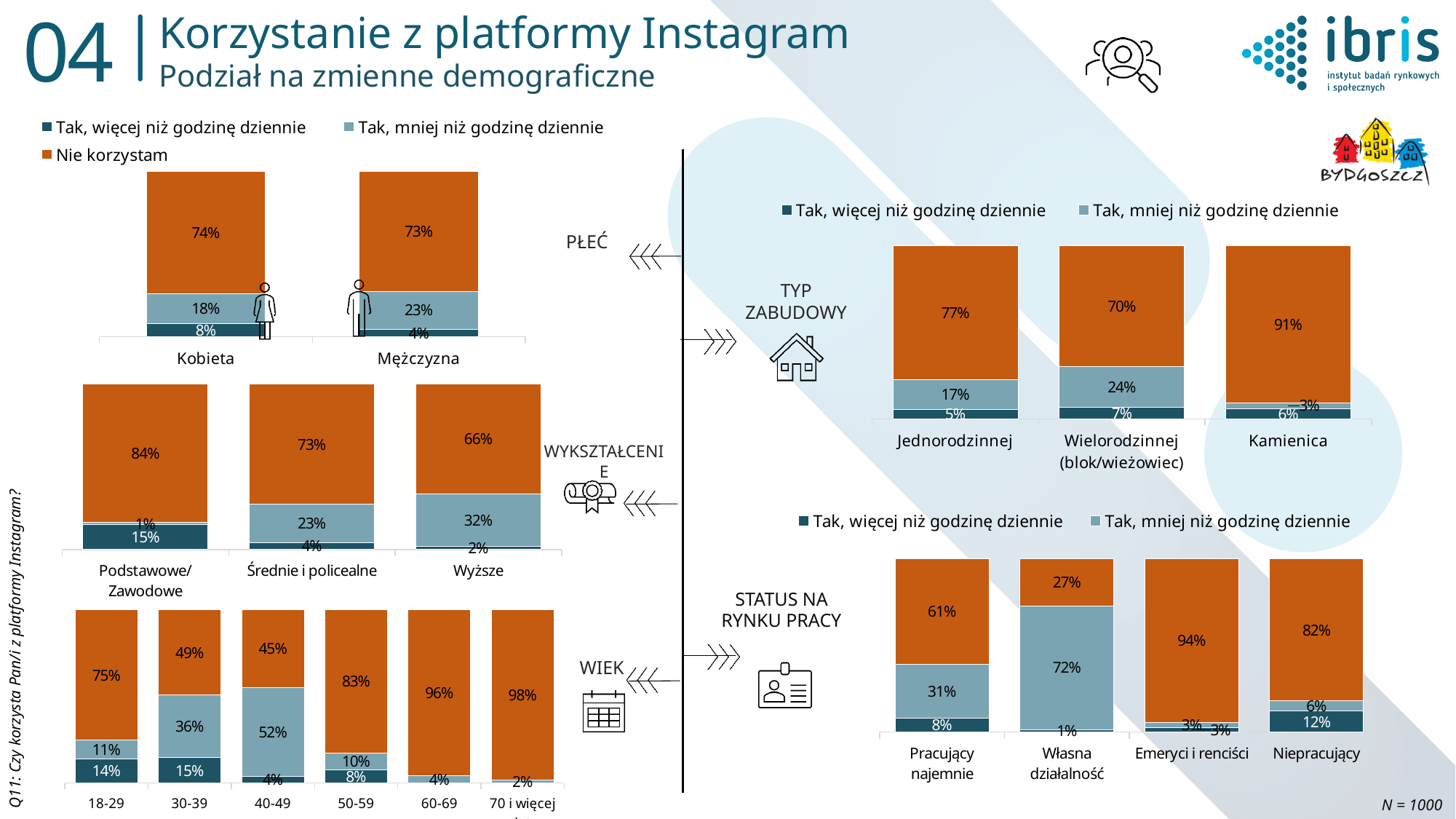
In the STATUS NA RYNKU PRACY chart, what percentage of Własna działalność respondents use Instagram less than an hour daily? 72% In the WYKSZTAŁCENIE chart, which education group has the highest share of "Nie korzystam"? Podstawowe/Zawodowe What type of chart is used for the WIEK section? Stacked bar chart In the WIEK chart, what percentage of the 40-49 group uses Instagram less than an hour daily? 52% In the TYP ZABUDOWY chart, what percentage of Kamienica residents answered "Nie korzystam"? 91% In the STATUS NA RYNKU PRACY chart, which group has the lowest share of "Nie korzystam"? Własna działalność In the WIEK chart, which age group has the highest share of "Nie korzystam"? 70 i więcej In the PŁEĆ chart, what percentage of women (Kobieta) answered "Nie korzystam"? 74% In the WIEK chart, how many age groups are shown? 6 In the TYP ZABUDOWY chart, which is larger: the "Tak, mniej niż godzinę dziennie" value for Jednorodzinnej or for Wielorodzinnej (blok/wieżowiec)? Wielorodzinnej (blok/wieżowiec) In the WYKSZTAŁCENIE chart, what is the difference between the "Tak, mniej niż godzinę dziennie" values for Wyższe and Średnie i policealne? 9 percentage points In the PŁEĆ chart, what percentage of men (Mężczyzna) use Instagram less than an hour daily ("Tak, mniej niż godzinę dziennie")? 23%